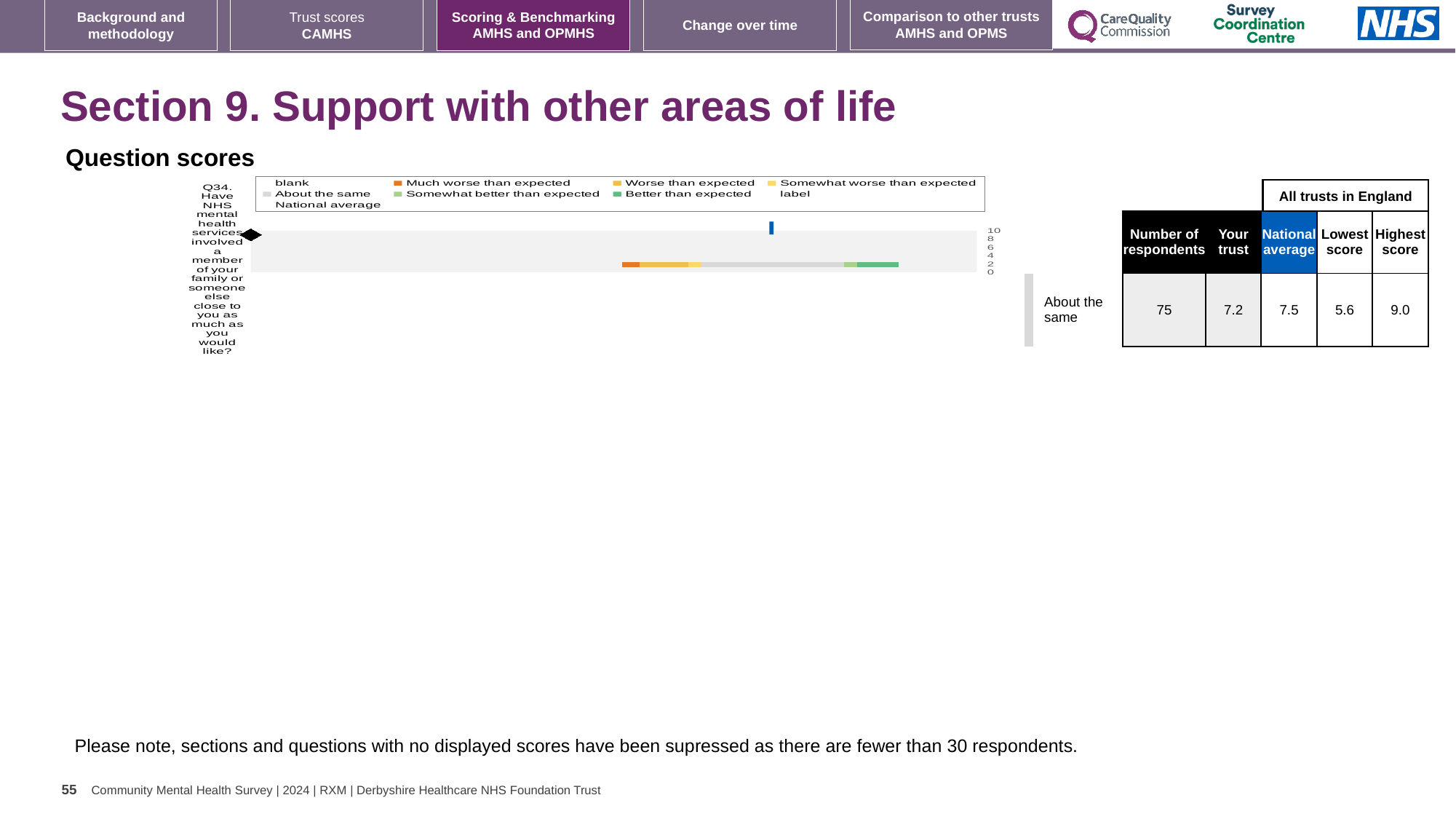
What benchmark category is the trust's Q34 score placed in? About the same What kind of chart is used to show the Q34 question score? bar chart In the question scores chart, what colour is the 'Much worse than expected' legend entry? orange What is the highest score among all trusts in England for Q34? 9.0 What is the number of respondents shown for Q34? 75 What is the difference between the highest score and the lowest score for Q34? 3.4 How many questions are plotted in the question scores chart? 1 What is the national average score for Q34? 7.5 What is the lowest score among all trusts in England for Q34? 5.6 For Q34, which is larger: the 'Your trust' score or the national average? National average What is the 'Your trust' score for Q34? 7.2 Which question is plotted in the question scores chart? Q34. Have NHS mental health services involved a member of your family or someone else close to you as much as you would like?